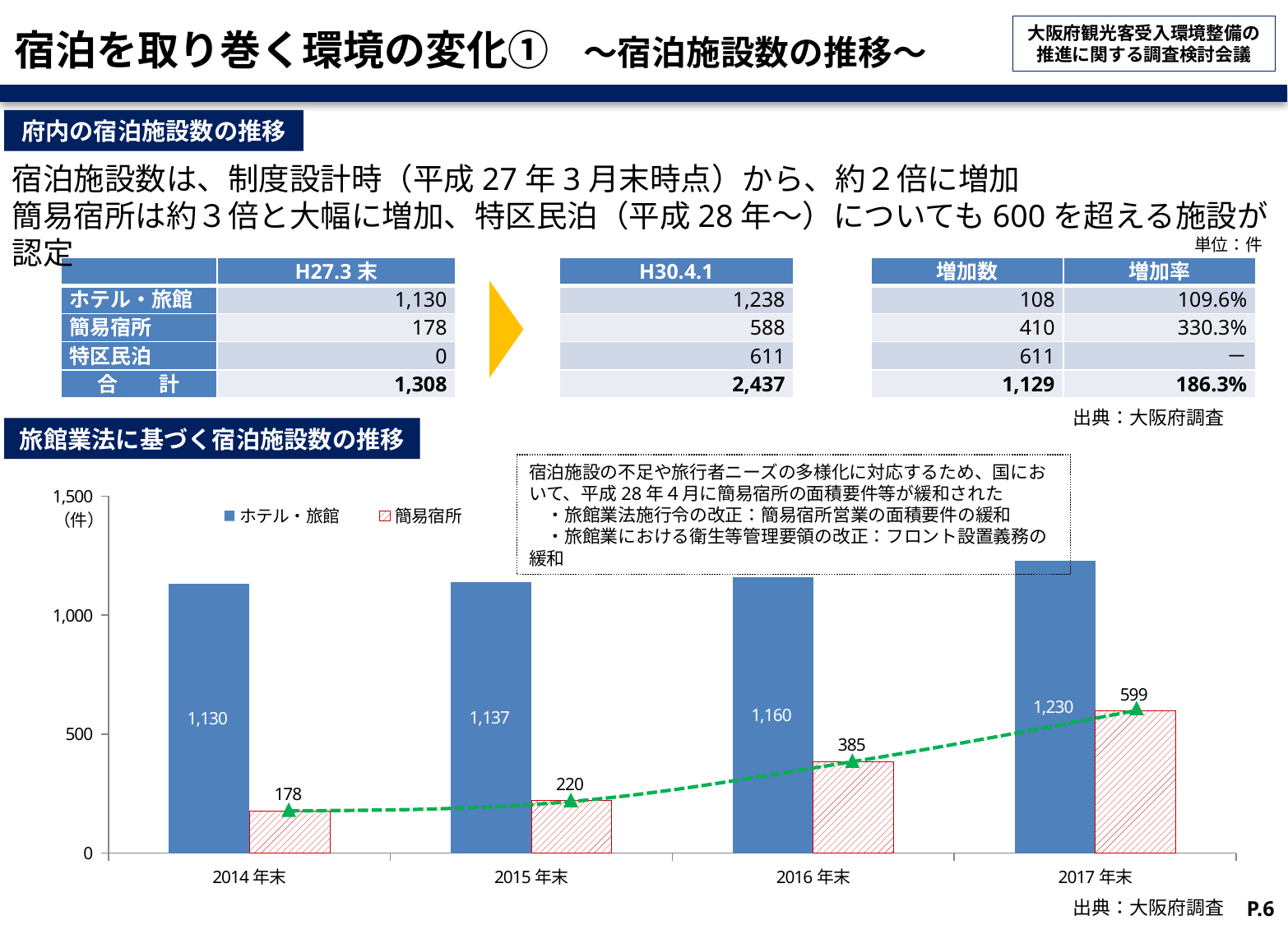
What is the value for 簡易宿所 in 2016年末? 385 In which year is the value for ホテル・旅館 highest? 2017年末 What is the value for 簡易宿所 in 2017年末? 599 How many series does the chart legend list? 2 In which year is the value for 簡易宿所 lowest? 2014年末 What kind of chart is shown at the bottom of the slide? Bar chart What is the difference between the 簡易宿所 values for 2017年末 and 2014年末? 421 What is the value for ホテル・旅館 in 2014年末? 1,130 How many years are shown on the x axis of the chart? 4 Is the value for ホテル・旅館 in 2016年末 greater or less than 1,000? greater Which is larger in 2015年末: ホテル・旅館 or 簡易宿所? ホテル・旅館 Do the values for 簡易宿所 rise or fall from 2014年末 to 2017年末? Rise